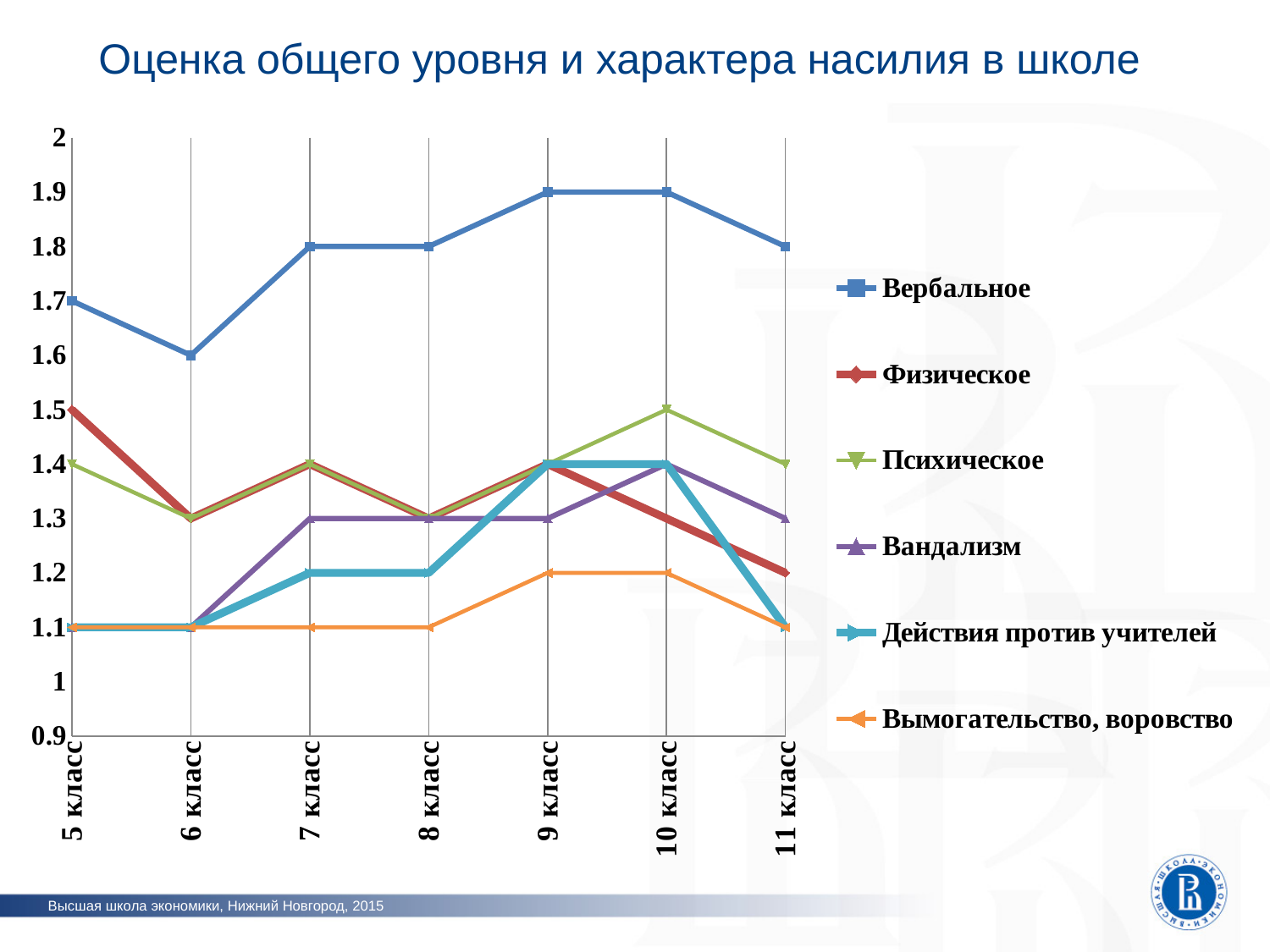
What kind of chart is shown on the slide? line chart Does the Физическое series rise or fall from 10 класс to 11 класс? fall What is the value for Физическое at 5 класс? 1.5 What is the value for Психическое at 10 класс? 1.5 How many series does the legend list? 6 What is the value for Вербальное at 6 класс? 1.6 What is the difference between Вербальное and Вымогательство, воровство at 9 класс? 0.7 Which series has the highest value at 9 класс? Вербальное Which is larger at 11 класс: Физическое or Психическое? Психическое Is the value for Вандализм at 10 класс greater or less than 1.2? greater At which class does the Вербальное series reach its lowest value? 6 класс How many categories (classes) are shown on the x axis? 7